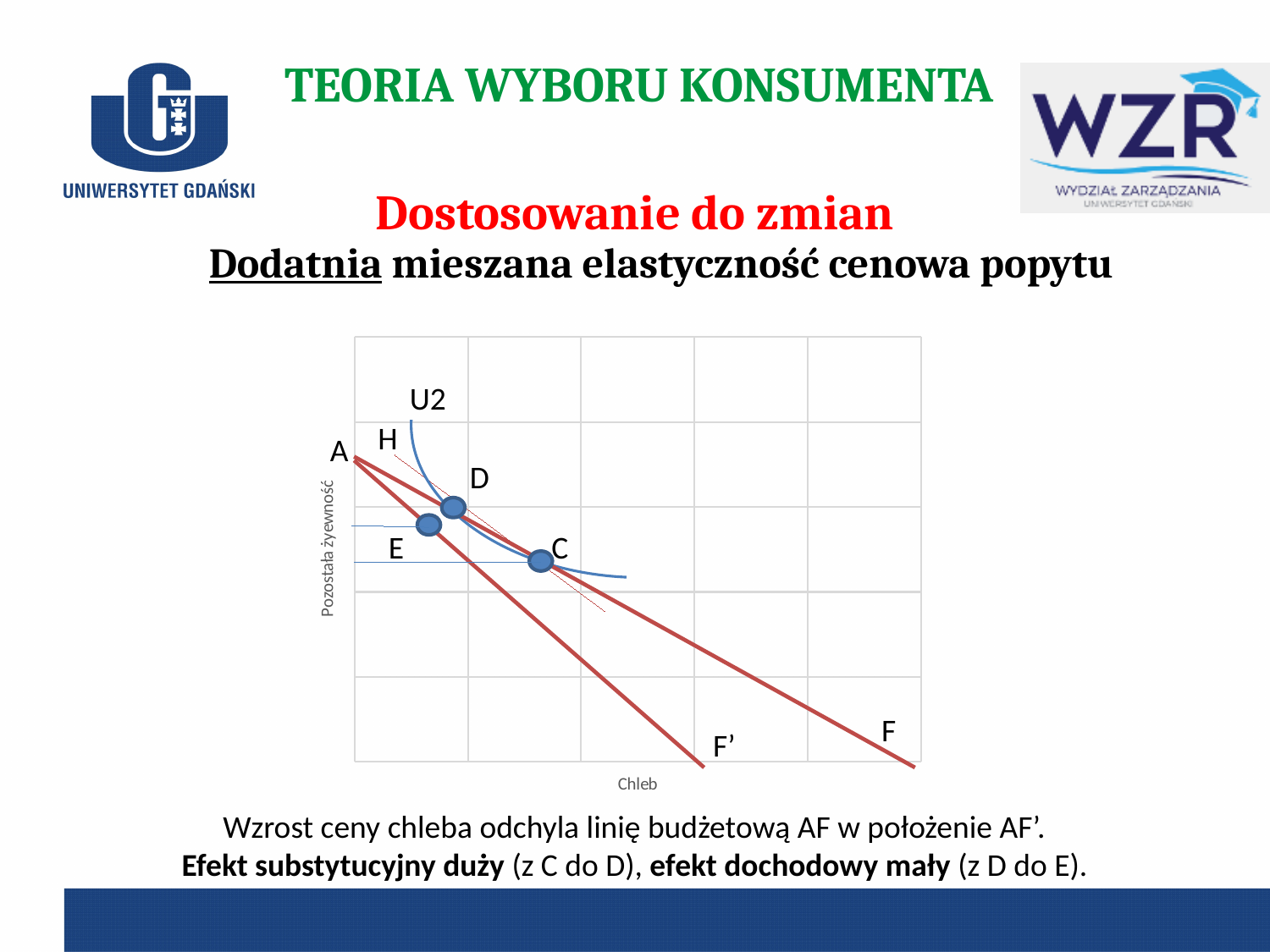
What is the label of the vertical axis of the chart? Pozostała żywność Do the budget lines AF and AF' rise or fall as Chleb increases? fall Which budget line is steeper, AF or AF'? AF' Which of the marked points D, E and C lies lowest on the vertical axis? C What kind of chart is shown on the slide? line chart Which of the marked points D, E and C lies highest on the vertical axis? D How many points are marked with filled circles on the chart? 3 What is the label of the indifference curve on the chart? U2 What is the label of the horizontal axis of the chart? Chleb Which budget line reaches further along the horizontal axis, AF or AF'? AF Which point is higher on the vertical axis, D or E? D